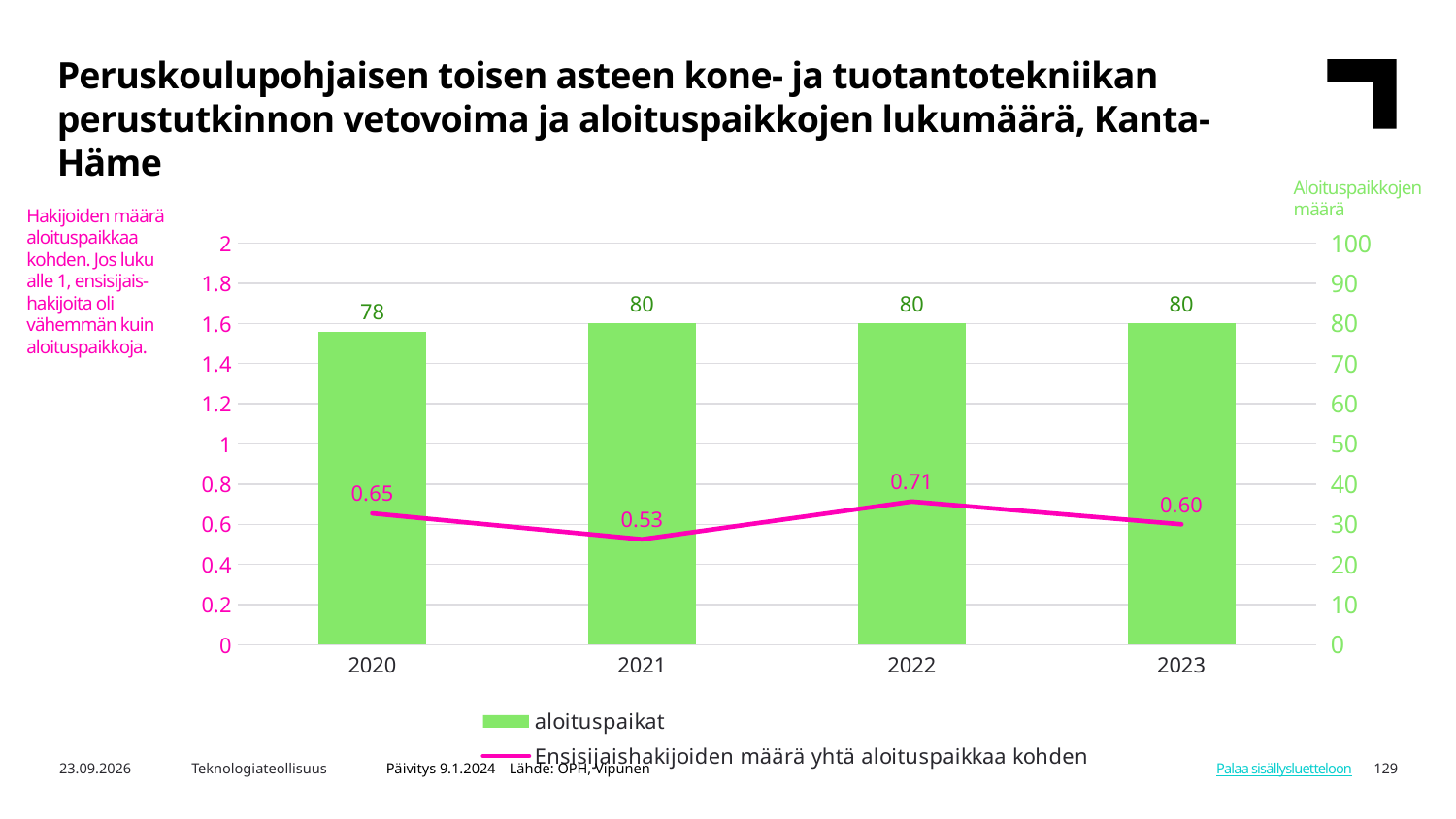
Does the Ensisijaishakijoiden määrä yhtä aloituspaikkaa kohden line rise or fall from 2020 to 2021? fall Which year has a higher value of Ensisijaishakijoiden määrä yhtä aloituspaikkaa kohden, 2020 or 2023? 2020 What is the difference in aloituspaikat between 2021 and 2020? 2 What is the value of Ensisijaishakijoiden määrä yhtä aloituspaikkaa kohden for 2022? 0.71 What is the value of aloituspaikat for 2020? 78 In which year is the value of aloituspaikat the lowest? 2020 What is the value of Ensisijaishakijoiden määrä yhtä aloituspaikkaa kohden for 2021? 0.53 What is the difference between the Ensisijaishakijoiden määrä yhtä aloituspaikkaa kohden values for 2022 and 2021? 0.18 How many years are shown on the x axis of the chart? 4 In which year is Ensisijaishakijoiden määrä yhtä aloituspaikkaa kohden the lowest? 2021 How many series does the chart legend list? 2 In which year is Ensisijaishakijoiden määrä yhtä aloituspaikkaa kohden the highest? 2022